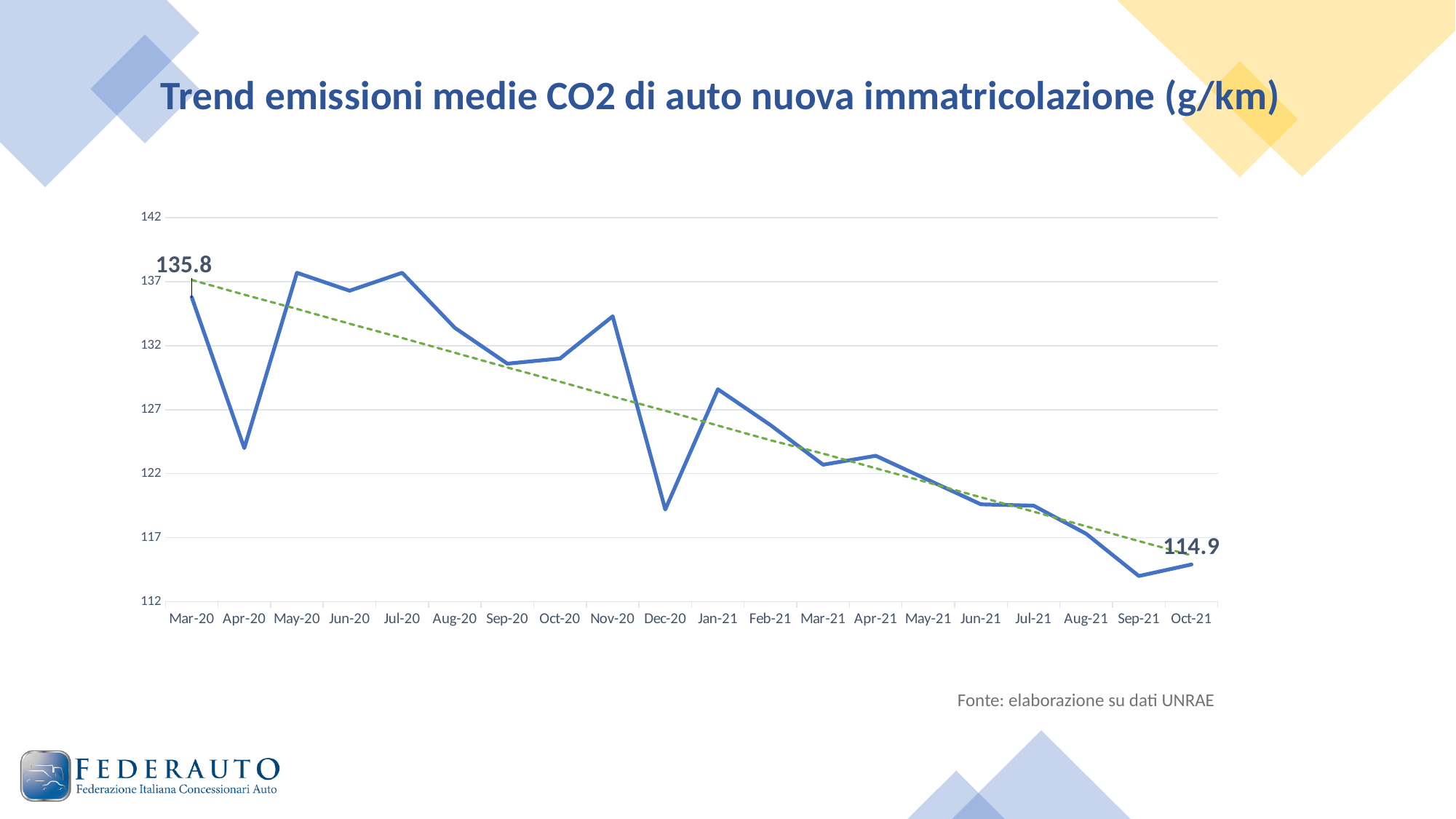
Is the value for Apr-20 greater or less than 127? less What is the difference between the Mar-20 value and the Oct-21 value? 20.9 Which is larger, the value for Nov-20 or the value for Dec-20? Nov-20 What is the source cited below the chart? Fonte: elaborazione su dati UNRAE What is the value for Mar-20? 135.8 Do the values generally rise or fall from Mar-20 to Oct-21? Fall What is the value for Oct-21? 114.9 Is the value for Dec-20 greater or less than 122? less Is the value for Nov-20 greater or less than 132? greater What kind of chart is shown on the slide? Line chart How many months are plotted along the x axis? 20 What is the title of the chart? Trend emissioni medie CO2 di auto nuova immatricolazione (g/km)